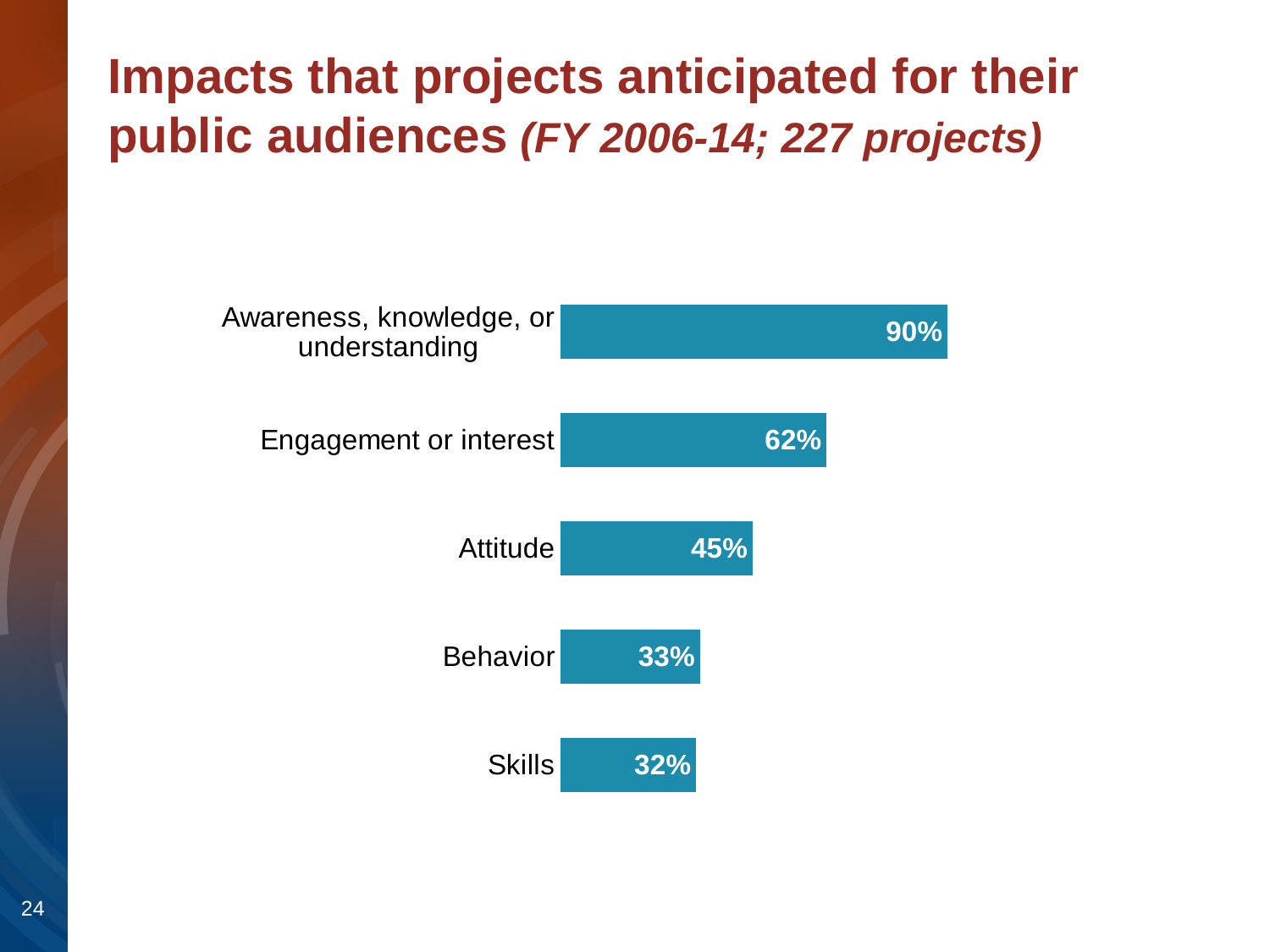
How many categories are shown in the chart? 5 How many projects does the slide title say the chart covers? 227 projects Which is larger, the value for Attitude or the value for Behavior? Attitude What is the difference between the values for Awareness, knowledge, or understanding and Skills? 58% Which category has the lowest value? Skills What kind of chart is shown on the slide? Bar chart What is the value shown for Attitude? 45% Which category has the highest value? Awareness, knowledge, or understanding What is the value shown for Skills? 32% What percentage of projects anticipated impacts on awareness, knowledge, or understanding? 90% What is the difference between the values for Engagement or interest and Attitude? 17% What is the value shown for Engagement or interest? 62%